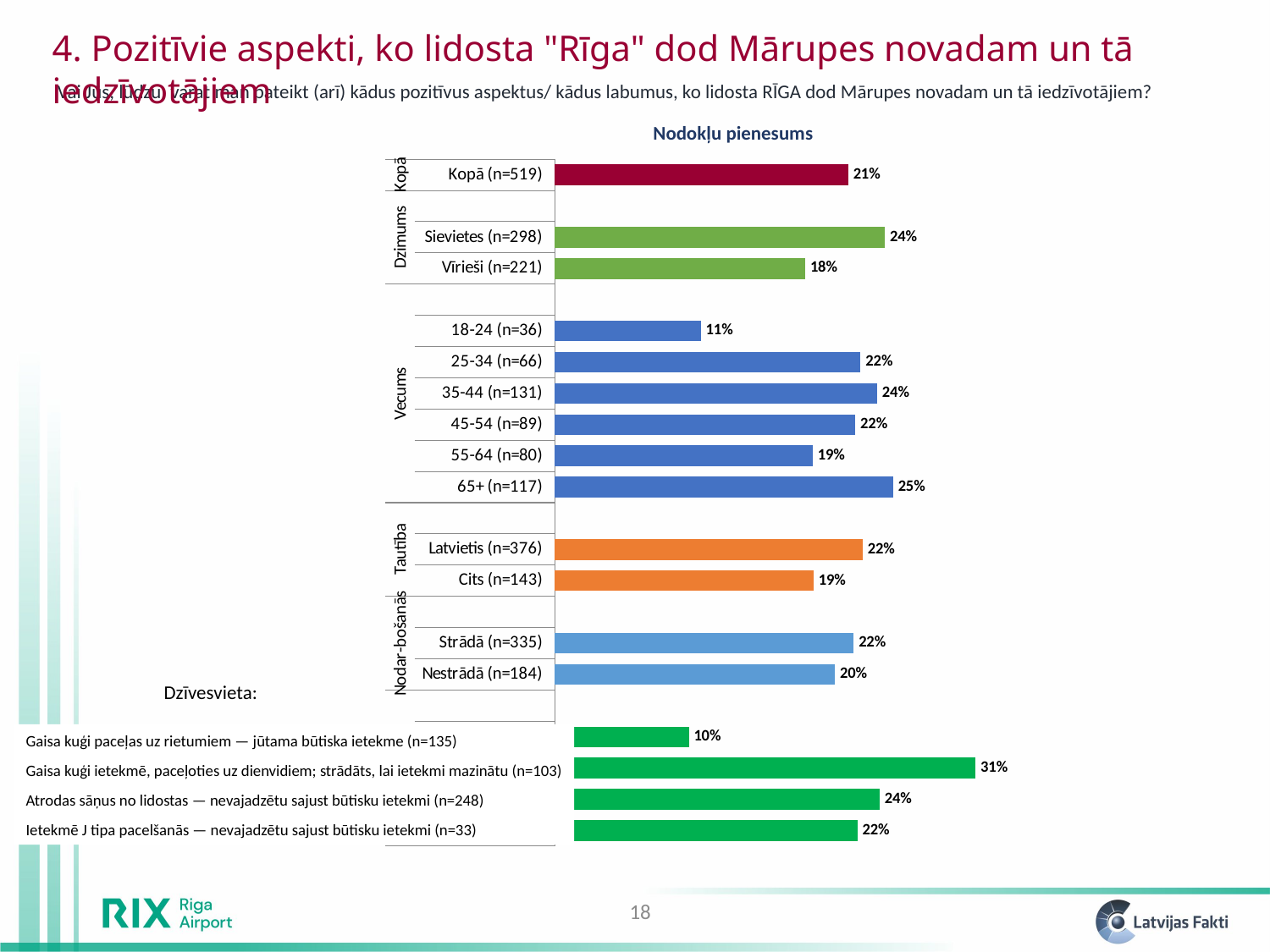
Among the Dzīvesvieta bars at the bottom of the slide, which category has the highest value? Gaisa kuģi ietekmē, paceļoties uz dienvidiem; strādāts, lai ietekmi mazinātu (n=103) In the Nodokļu pienesums chart, what is the value for Kopā (n=519)? 21% How many age groups (Vecums) are plotted in the Nodokļu pienesums chart? 6 What kind of chart is shown under the title Nodokļu pienesums? Bar chart What is the title of the chart on the slide? Nodokļu pienesums In the Nodokļu pienesums chart, which age group (Vecums) has the highest value? 65+ (n=117) In the Nodokļu pienesums chart, what is the value for Nestrādā (n=184)? 20% In the Nodokļu pienesums chart, which is larger: the value for Latvietis (n=376) or for Cits (n=143)? Latvietis (n=376) In the Nodokļu pienesums chart, what is the value for Vīrieši (n=221)? 18% Among the Dzīvesvieta bars at the bottom of the slide, what is the value for Atrodas sāņus no lidostas — nevajadzētu sajust būtisku ietekmi (n=248)? 24% In the Nodokļu pienesums chart, which age group (Vecums) has the lowest value? 18-24 (n=36) In the Nodokļu pienesums chart, what is the difference between the values for Sievietes (n=298) and Vīrieši (n=221)? 6 percentage points